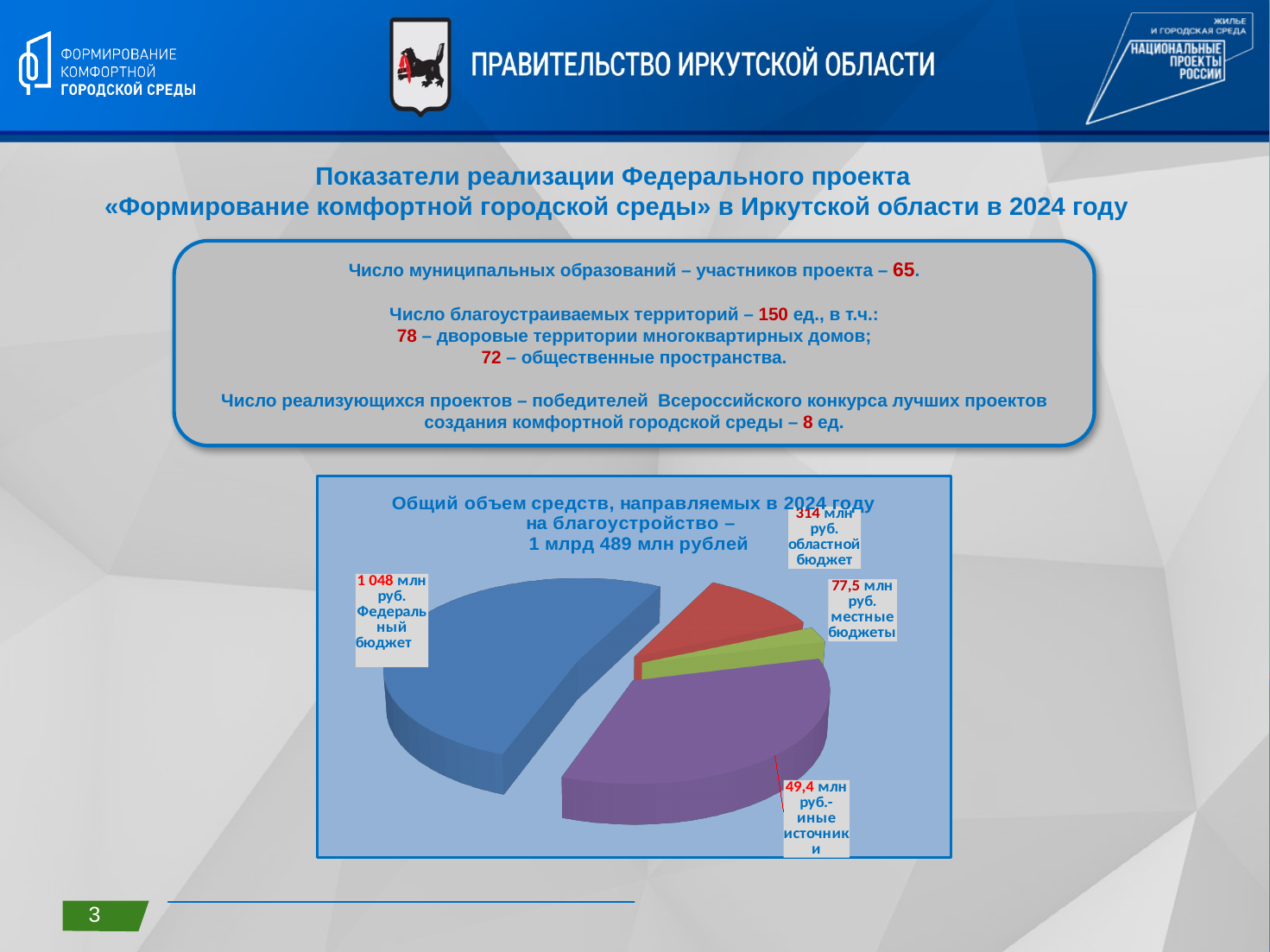
What total amount is stated in the pie chart's title? 1 млрд 489 млн рублей What is the value for областной бюджет in the pie chart? 314 млн руб. What is the value for местные бюджеты in the pie chart? 77,5 млн руб. What colour is the Федеральный бюджет slice in the pie chart? blue How many slices does the pie chart have? 4 What is the difference between Федеральный бюджет and областной бюджет? 734 млн руб. Which funding source has the largest value in the pie chart? Федеральный бюджет What is the value for Федеральный бюджет in the pie chart? 1 048 млн руб. What kind of chart is shown on the slide? pie chart What is the value for иные источники in the pie chart? 49,4 млн руб. What is the difference between областной бюджет and местные бюджеты? 236,5 млн руб. Which is larger, областной бюджет or местные бюджеты? областной бюджет